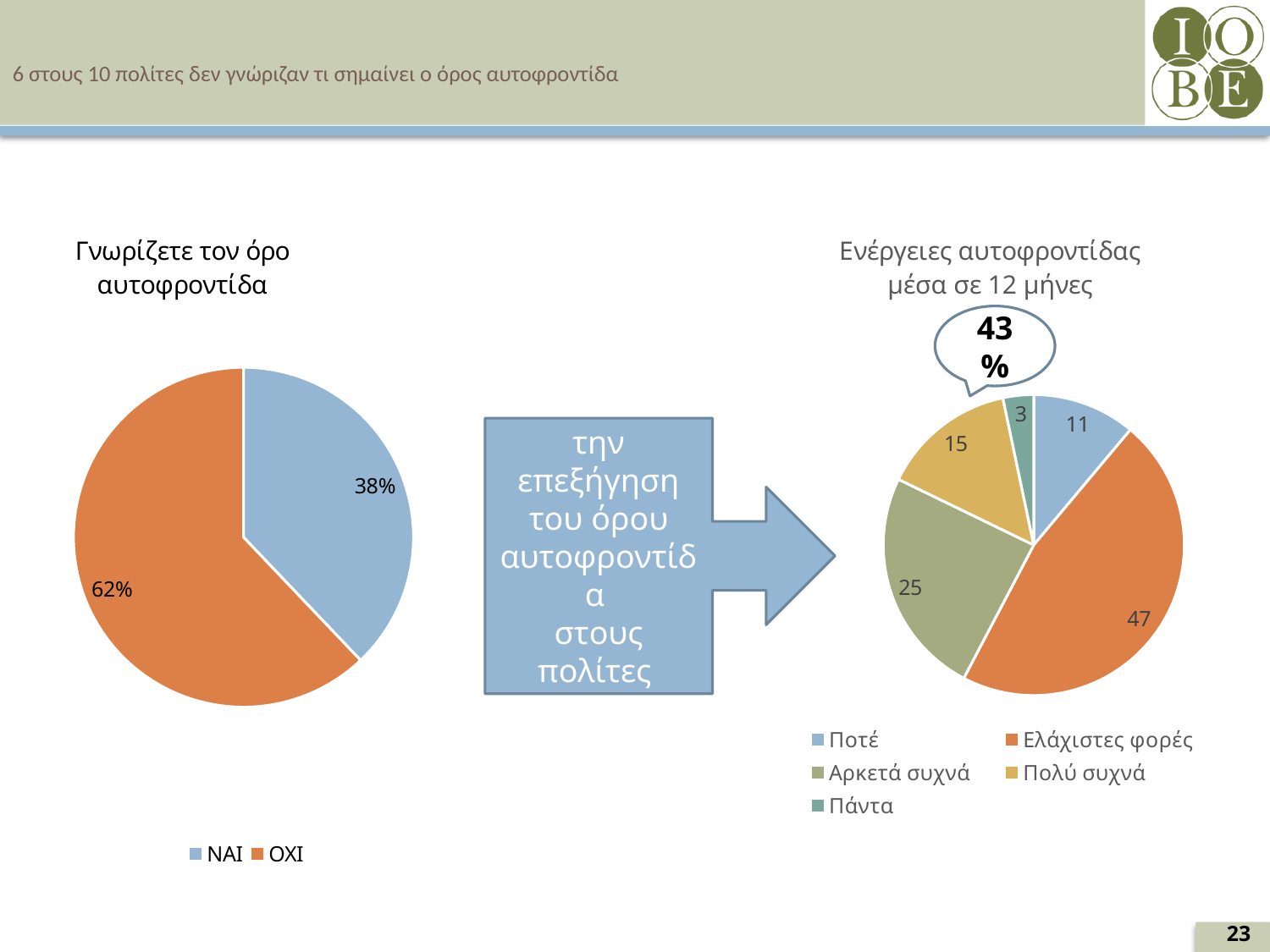
In the left chart 'Γνωρίζετε τον όρο αυτοφροντίδα', what is the value for ΟΧΙ? 62% In the right chart 'Ενέργειες αυτοφροντίδας μέσα σε 12 μήνες', what is the value for Ελάχιστες φορές? 47 What kind of chart is the left chart 'Γνωρίζετε τον όρο αυτοφροντίδα'? pie chart In the right chart 'Ενέργειες αυτοφροντίδας μέσα σε 12 μήνες', what is the difference between Ελάχιστες φορές and Ποτέ? 36 In the left chart 'Γνωρίζετε τον όρο αυτοφροντίδα', what is the value for ΝΑΙ? 38% In the right chart 'Ενέργειες αυτοφροντίδας μέσα σε 12 μήνες', what is the value for Αρκετά συχνά? 25 In the right chart 'Ενέργειες αυτοφροντίδας μέσα σε 12 μήνες', which is larger: Ποτέ or Πολύ συχνά? Πολύ συχνά In the left chart 'Γνωρίζετε τον όρο αυτοφροντίδα', what is the difference between ΟΧΙ and ΝΑΙ? 24% In the left chart 'Γνωρίζετε τον όρο αυτοφροντίδα', which category has the larger share? ΟΧΙ In the right chart 'Ενέργειες αυτοφροντίδας μέσα σε 12 μήνες', how many categories does the legend list? 5 In the right chart 'Ενέργειες αυτοφροντίδας μέσα σε 12 μήνες', which category has the smallest value? Πάντα In the right chart 'Ενέργειες αυτοφροντίδας μέσα σε 12 μήνες', which category has the largest value? Ελάχιστες φορές